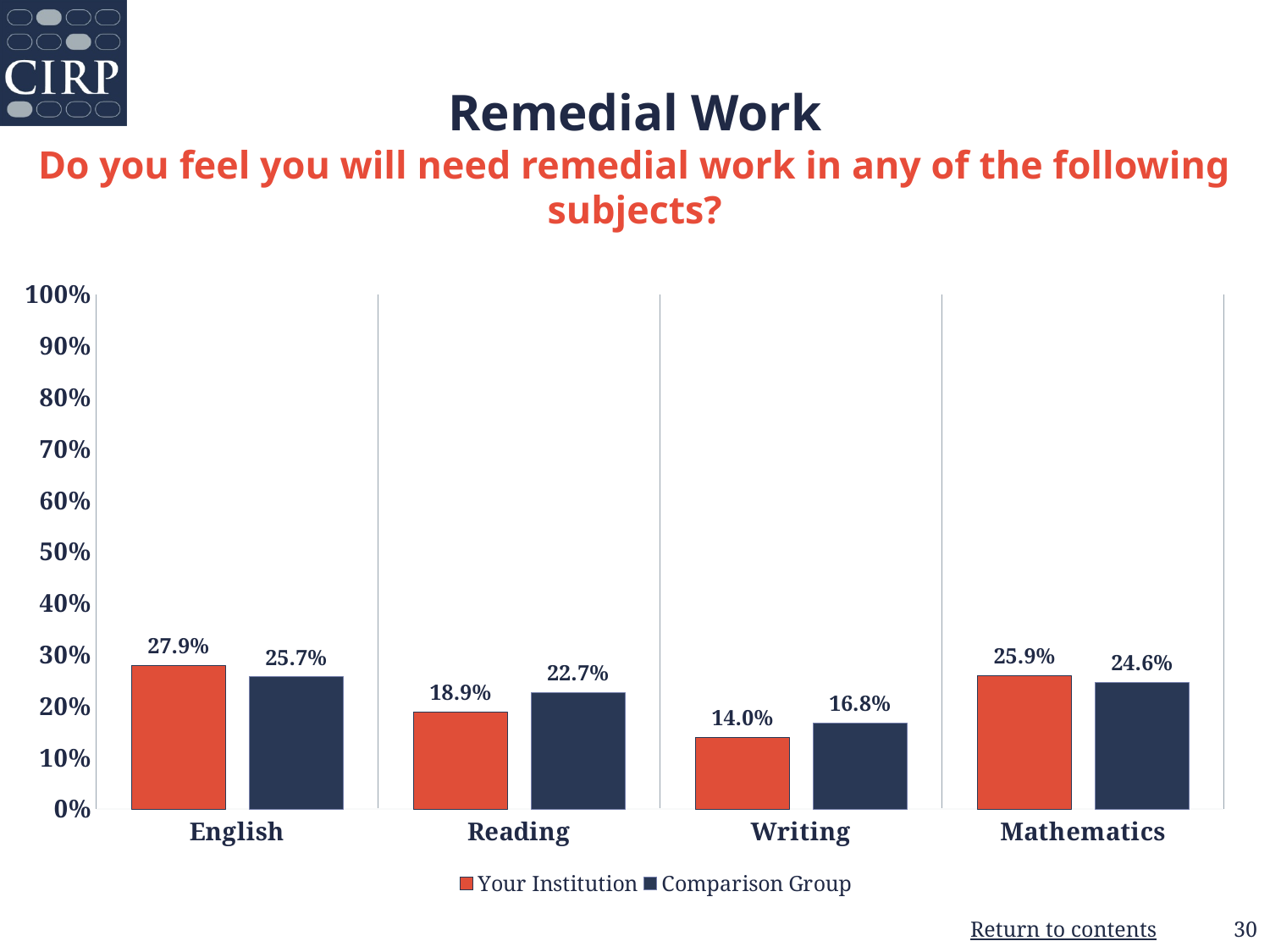
What is the value for Comparison Group for Mathematics? 24.6% Is the value for Comparison Group for English greater or less than 30%? less What is the value for Comparison Group for Reading? 22.7% What is the difference between Your Institution and Comparison Group for Reading? 3.8% What kind of chart is shown on the slide? bar chart How many subjects are shown on the x axis? 4 Which subject has the highest value for Your Institution? English How many series does the legend list? 2 Which subject has the lowest value for Comparison Group? Writing For Mathematics, which is larger: Your Institution or Comparison Group? Your Institution What is the value for Your Institution for English? 27.9% What is the value for Your Institution for Writing? 14.0%